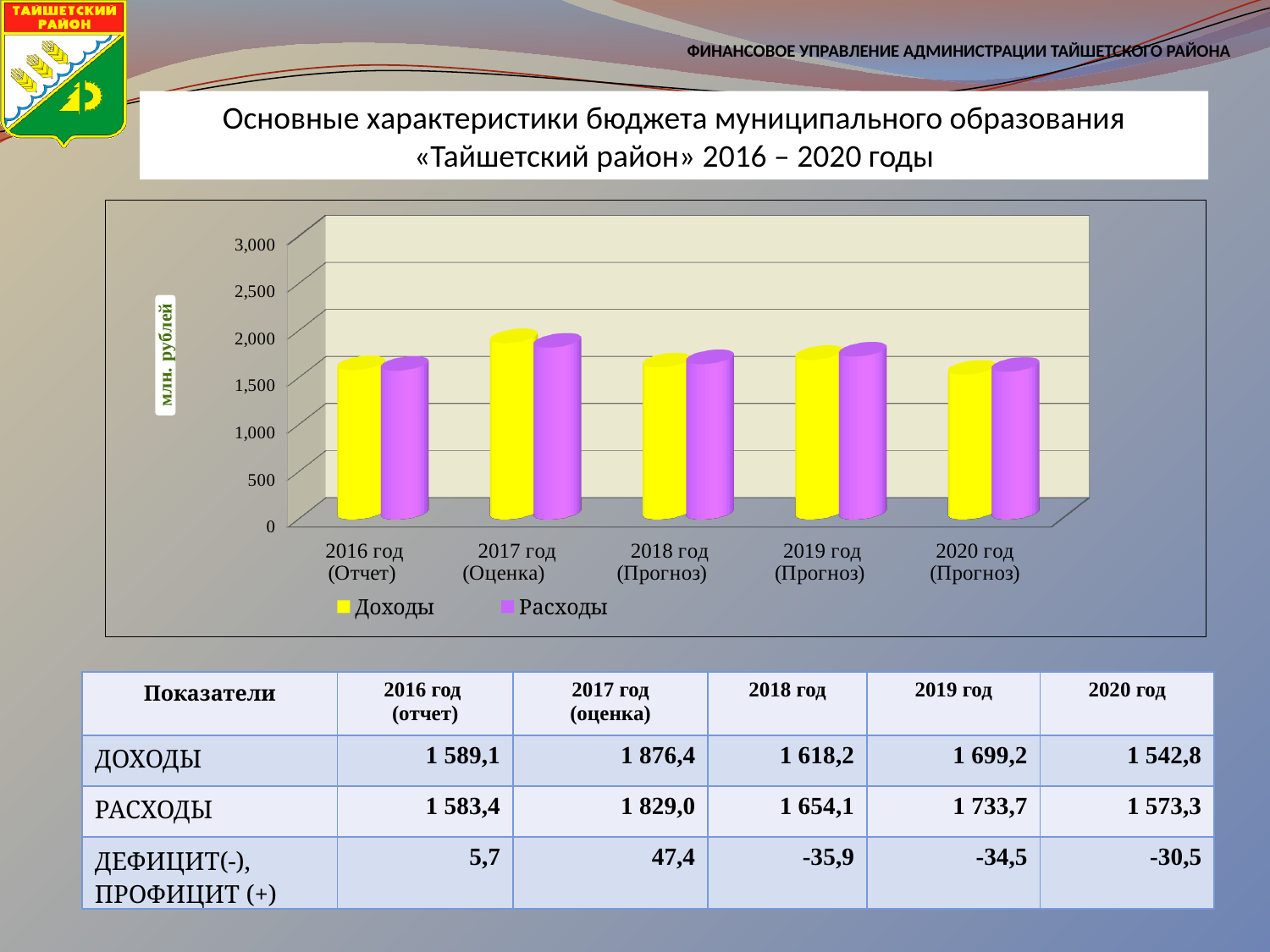
What is the difference between Доходы and Расходы in 2017 год (Оценка)? 47,4 In which year is Доходы the lowest? 2020 год (Прогноз) For 2018 год (Прогноз), which is larger, Доходы or Расходы? Расходы Is the value of Доходы for 2020 год (Прогноз) greater or less than 2,000? less How many year categories are plotted along the x axis of the chart? 5 What unit is shown on the vertical axis label of the chart? млн. рублей What type of chart is shown on the slide? bar chart Between 2019 год and 2020 год, do the Доходы values rise or fall? fall What is the value of Доходы for 2017 год (Оценка)? 1 876,4 What is the value of Расходы for 2019 год (Прогноз)? 1 733,7 How many series does the chart legend list? 2 In which year is Доходы the highest? 2017 год (Оценка)